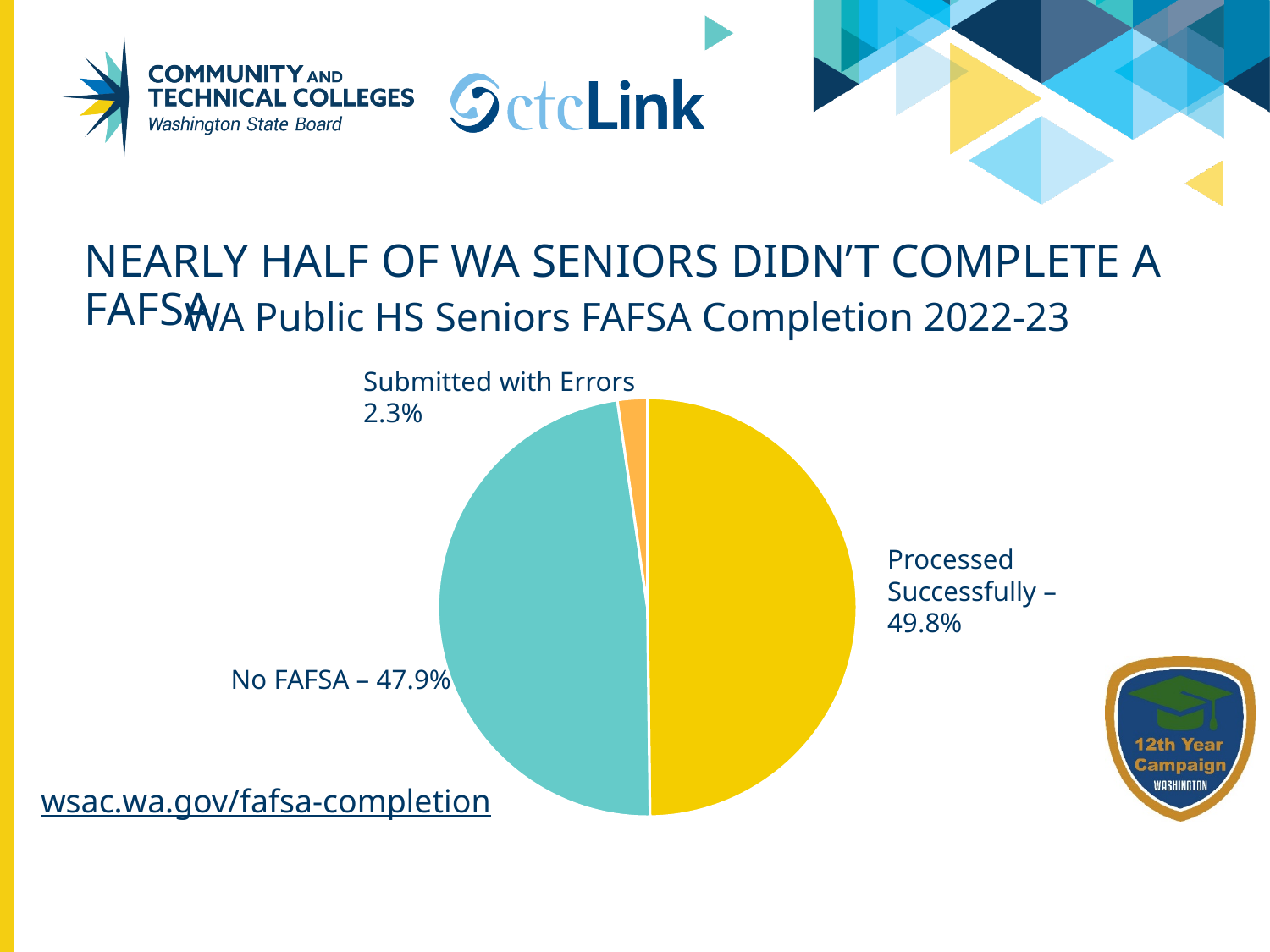
Which slice of the pie chart is the smallest? Submitted with Errors Which is larger: the No FAFSA slice or the Submitted with Errors slice? No FAFSA What percentage of WA public HS seniors submitted no FAFSA? 47.9% What is the title of the chart? WA Public HS Seniors FAFSA Completion 2022-23 What type of chart is shown on the slide? Pie chart What percentage of WA public HS seniors had their FAFSA processed successfully? 49.8% Which slice of the pie chart is the largest? Processed Successfully What is the difference in percentage points between Processed Successfully and No FAFSA? 1.9 What colour is the Processed Successfully slice? Yellow What is the difference in percentage points between No FAFSA and Submitted with Errors? 45.6 How many slices does the pie chart have? 3 What percentage of WA public HS seniors submitted a FAFSA with errors? 2.3%